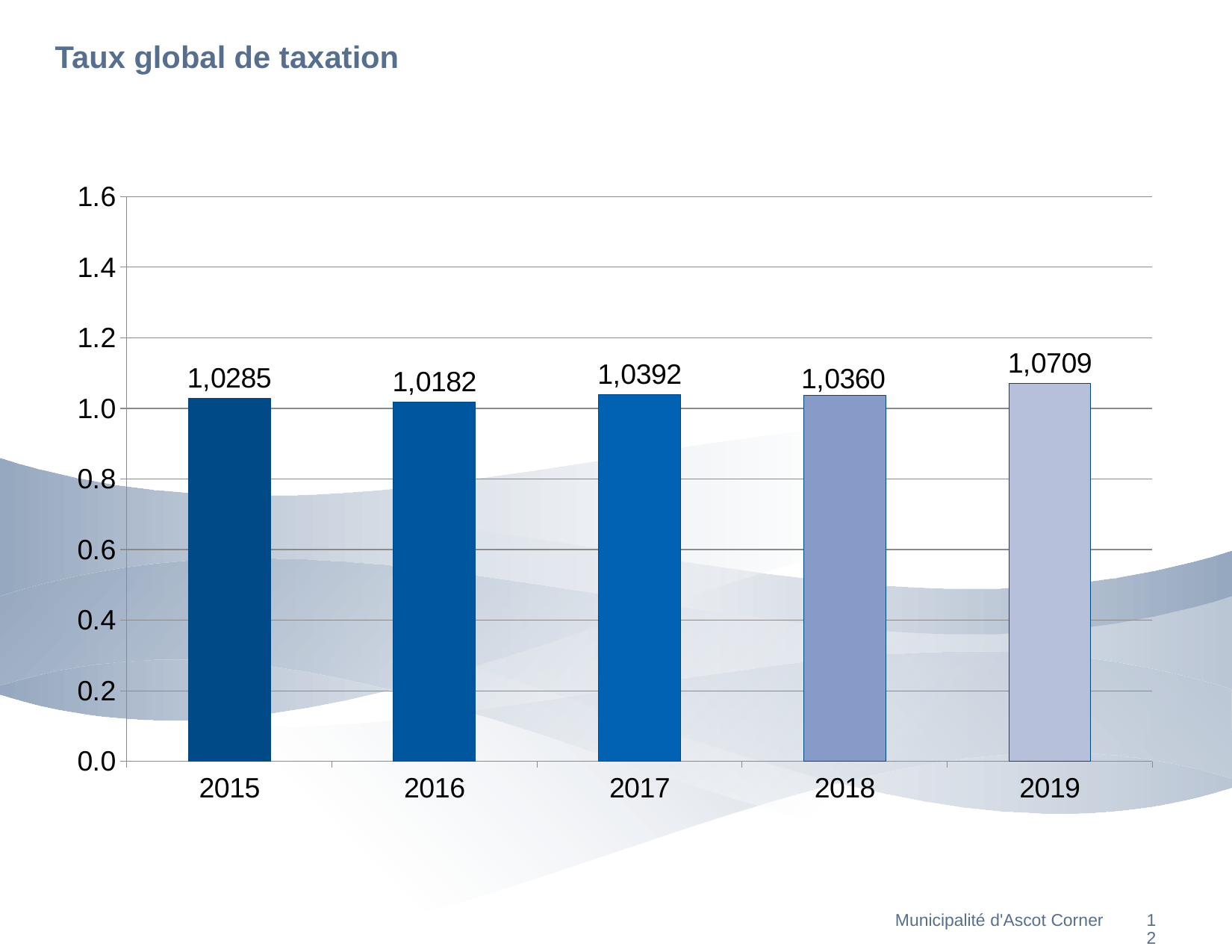
Is the value for 2016 greater or less than 1.2? less Which year has the lowest value? 2016 Which is larger, the value for 2017 or the value for 2018? 2017 What kind of chart is shown on the slide? bar chart What is the title of the slide? Taux global de taxation What is the value for 2017? 1,0392 Which year has the highest value? 2019 What is the difference between the values for 2019 and 2018? 0,0349 What is the value for 2019? 1,0709 Does the value rise or fall from 2018 to 2019? rise How many years are shown on the x axis? 5 What is the value for 2015? 1,0285